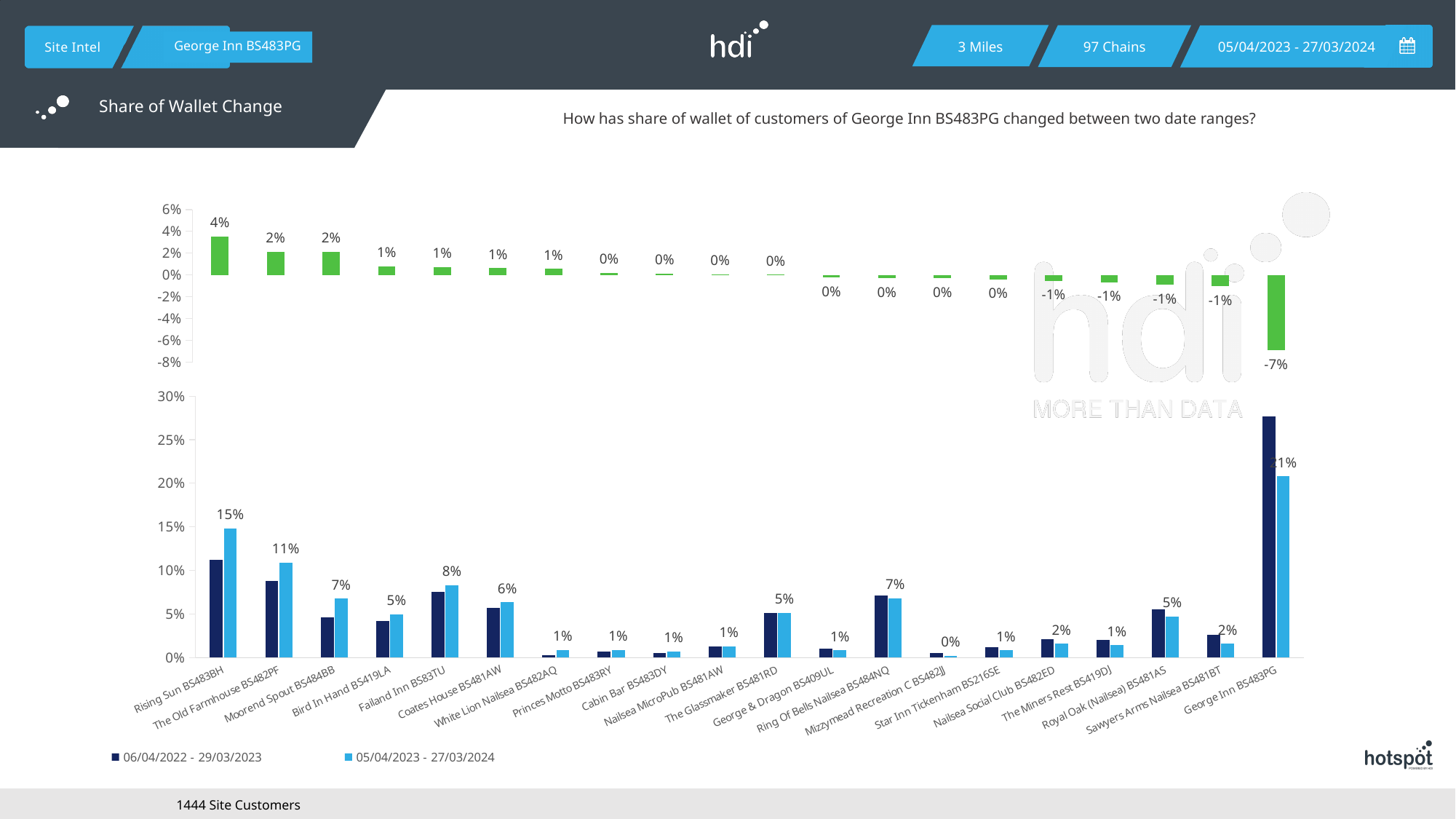
In the top chart, what is the share of wallet change for George Inn BS483PG? -7% In the bottom chart, what is the share of wallet for Rising Sun BS483BH in the 05/04/2023 - 27/03/2024 period? 15% In the bottom chart, what is the share of wallet for George Inn BS483PG in the 05/04/2023 - 27/03/2024 period? 21% In the bottom chart, what is the difference between the 05/04/2023 - 27/03/2024 values for Rising Sun BS483BH and The Old Farmhouse BS482PF? 4% In the top chart, what is the share of wallet change for Rising Sun BS483BH? 4% In the bottom chart, how many series does the legend list? 2 In the bottom chart, is the 06/04/2022 - 29/03/2023 value for George Inn BS483PG greater or less than 25%? greater In the bottom chart, what is the share of wallet for Failand Inn BS83TU in the 05/04/2023 - 27/03/2024 period? 8% In the bottom chart, how many pubs are shown on the x axis? 20 In the top chart, which pub has the highest share of wallet change? Rising Sun BS483BH What type of chart is the bottom chart? Bar chart In the top chart, which pub has the lowest share of wallet change? George Inn BS483PG